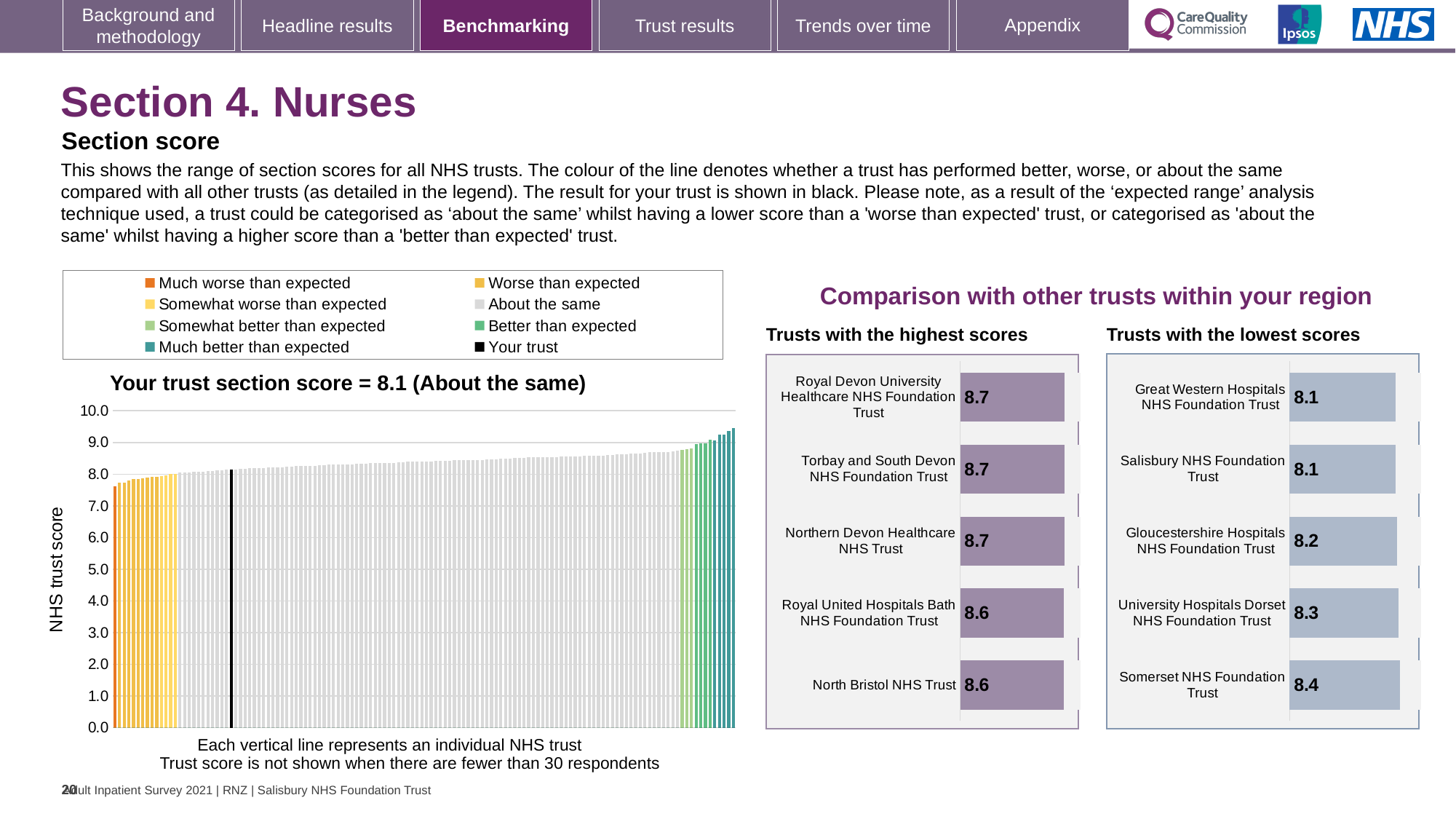
On the 'Trusts with the lowest scores' chart, what is the difference between the scores of Somerset NHS Foundation Trust and Great Western Hospitals NHS Foundation Trust? 0.3 How many trusts are shown on the 'Trusts with the lowest scores' chart? 5 What is the section score for your trust shown in the title of the left-hand chart? 8.1 (About the same) What kind of chart is the 'Your trust section score' chart on the left? Bar chart On the 'Trusts with the highest scores' chart, which has the larger score: Royal Devon University Healthcare NHS Foundation Trust or North Bristol NHS Trust? Royal Devon University Healthcare NHS Foundation Trust How many entries does the legend of the 'Your trust section score' chart list? 8 On the 'Trusts with the highest scores' chart, what is the score for Royal Devon University Healthcare NHS Foundation Trust? 8.7 On the 'Your trust section score' chart, do the bar heights rise or fall from left to right? Rise On the 'Your trust section score' chart, is the value of the tallest bar greater or less than 9.0? greater On the 'Trusts with the highest scores' chart, what is the score for North Bristol NHS Trust? 8.6 On the 'Trusts with the lowest scores' chart, which trust has the highest score? Somerset NHS Foundation Trust On the 'Trusts with the lowest scores' chart, what is the score for Gloucestershire Hospitals NHS Foundation Trust? 8.2